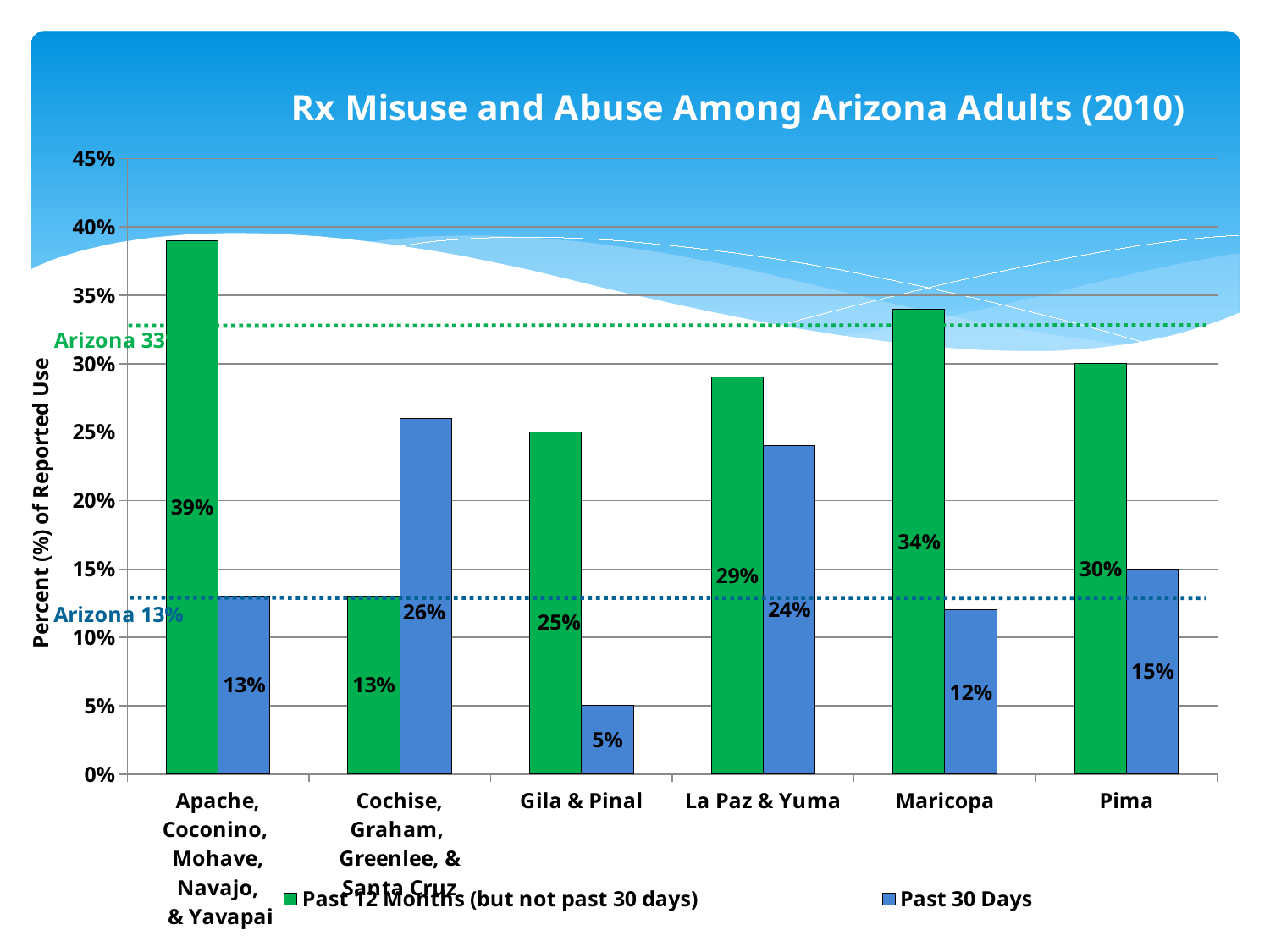
Is the Past 12 Months (but not past 30 days) value for Apache, Coconino, Mohave, Navajo, & Yavapai greater or less than 35%? greater How many series does the legend list? 2 Which region has the lowest Past 30 Days value? Gila & Pinal What is the Past 30 Days value for Gila & Pinal? 5% What is the difference between the Past 12 Months (but not past 30 days) value and the Past 30 Days value for Pima? 15% What is the Past 12 Months (but not past 30 days) value for Maricopa? 34% What is the title of the chart? Rx Misuse and Abuse Among Arizona Adults (2010) What is the Past 30 Days value for Cochise, Graham, Greenlee, & Santa Cruz? 26% Which is larger for La Paz & Yuma: the Past 12 Months (but not past 30 days) value or the Past 30 Days value? Past 12 Months (but not past 30 days) What kind of chart is shown on the slide? bar chart Which region has the highest Past 12 Months (but not past 30 days) value? Apache, Coconino, Mohave, Navajo, & Yavapai How many regions are shown on the x axis? 6